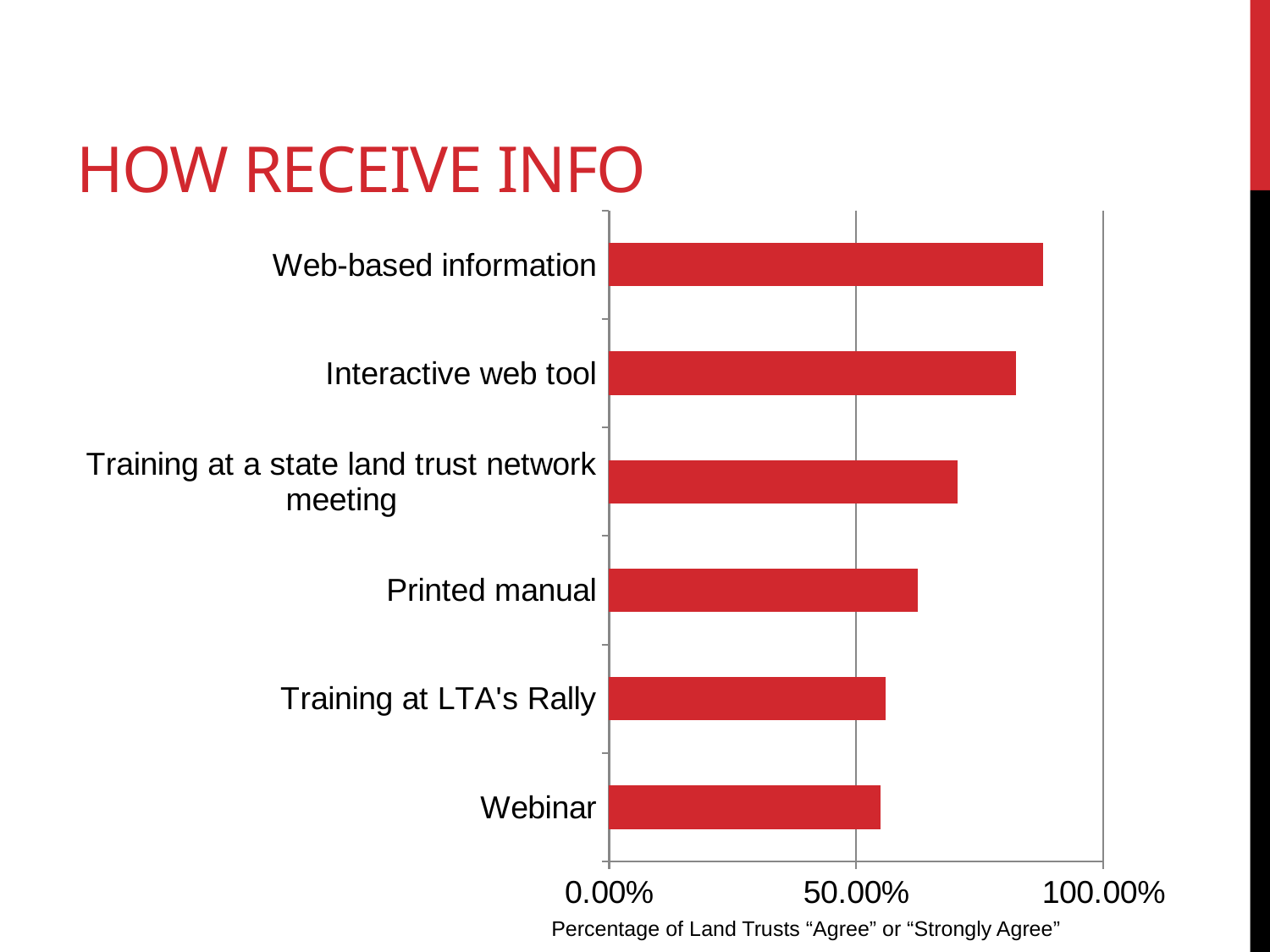
Is the value for Printed manual greater or less than 50.00%? greater Which is larger, the value for Interactive web tool or the value for Training at a state land trust network meeting? Interactive web tool What is the title of the chart on the slide? HOW RECEIVE INFO Which category has the highest value in the chart? Web-based information Is the value for Web-based information greater or less than 100.00%? less Is the value for Web-based information greater or less than 50.00%? greater Which is larger, the value for Web-based information or the value for Printed manual? Web-based information What is the label on the horizontal axis of the chart? Percentage of Land Trusts "Agree" or "Strongly Agree" What kind of chart is shown on the slide? bar chart How many categories are plotted in the chart? 6